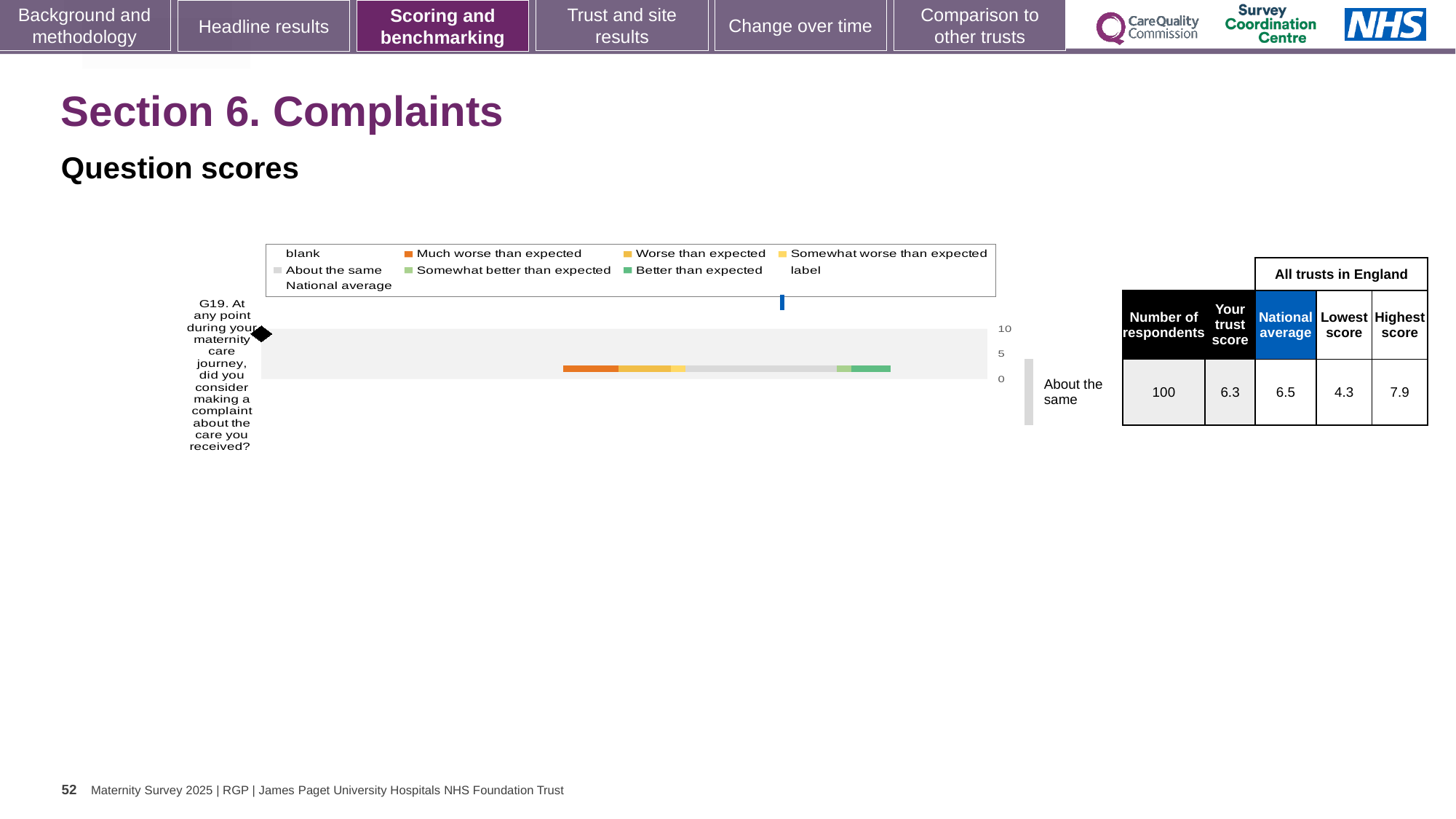
What is the difference between the highest score and the lowest score for G19? 3.6 What is the trust score for question G19? 6.3 What is the highest tick value shown on the chart's axis? 10 How many questions (categories) are plotted in the chart? 1 Which question number is plotted in the chart? G19 What kind of chart is shown on the slide? bar chart What benchmark rating is shown for question G19? About the same Is the trust score for G19 greater or less than 5? greater What is the difference between the national average and the trust score for G19? 0.2 What is the national average for question G19? 6.5 Which is larger for G19, the trust score or the national average? national average